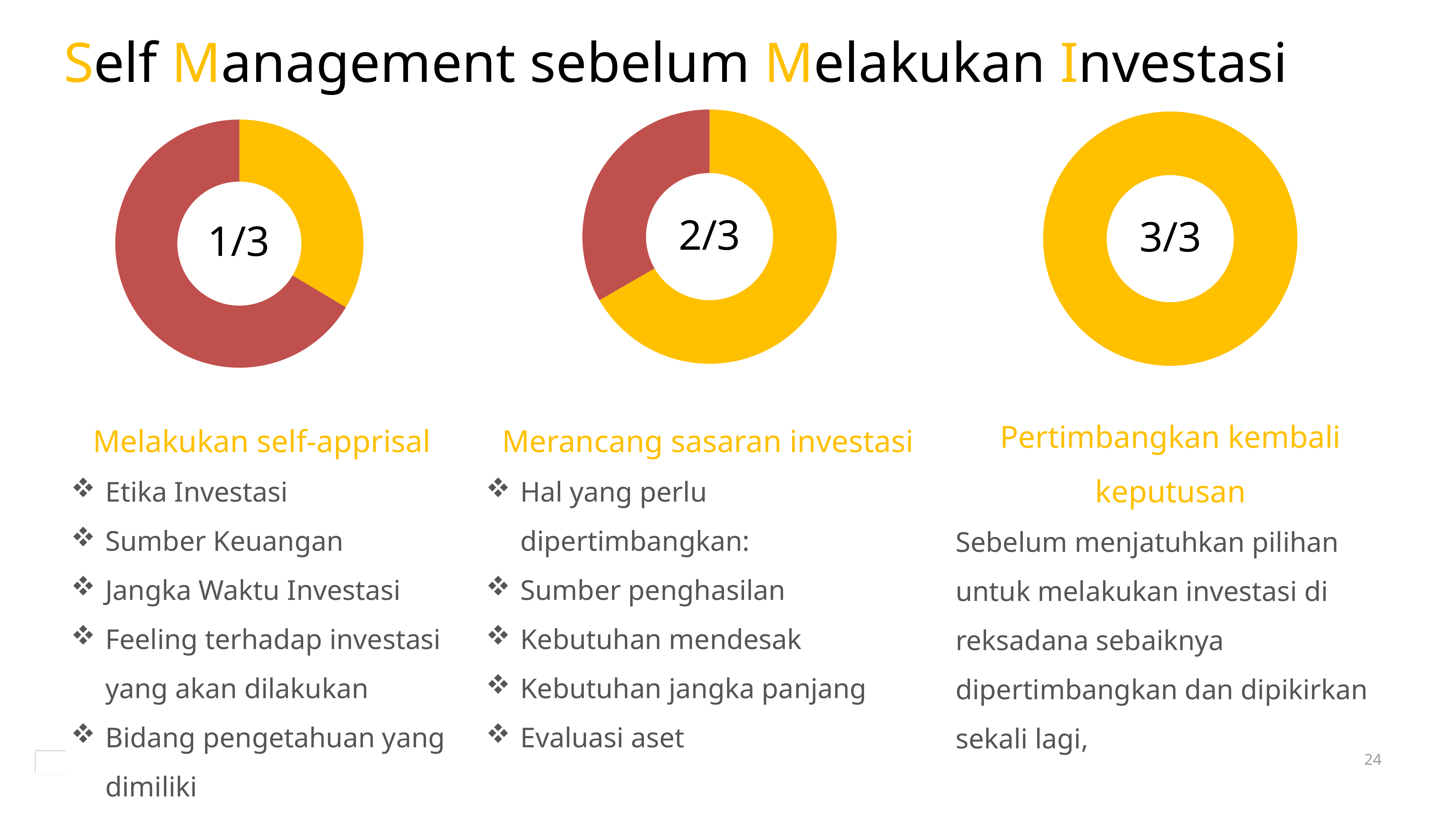
What text is printed in the centre of the middle donut chart? 2/3 In the left donut chart, which colour covers the larger share, red or yellow? Red What kind of chart is shown on the left of the slide? Donut chart What text is printed in the centre of the right donut chart? 3/3 In the middle donut chart, which colour covers the larger share, red or yellow? Yellow What colour fills the entire ring of the right donut chart? Yellow What fraction of the middle donut chart is filled yellow, according to its centre label? 2/3 How many coloured segments does the right donut chart have? 1 How many donut charts are on the slide? 3 How many coloured segments does the left donut chart have? 2 What text is printed in the centre of the left donut chart? 1/3 What is the heading printed below the middle donut chart? Merancang sasaran investasi